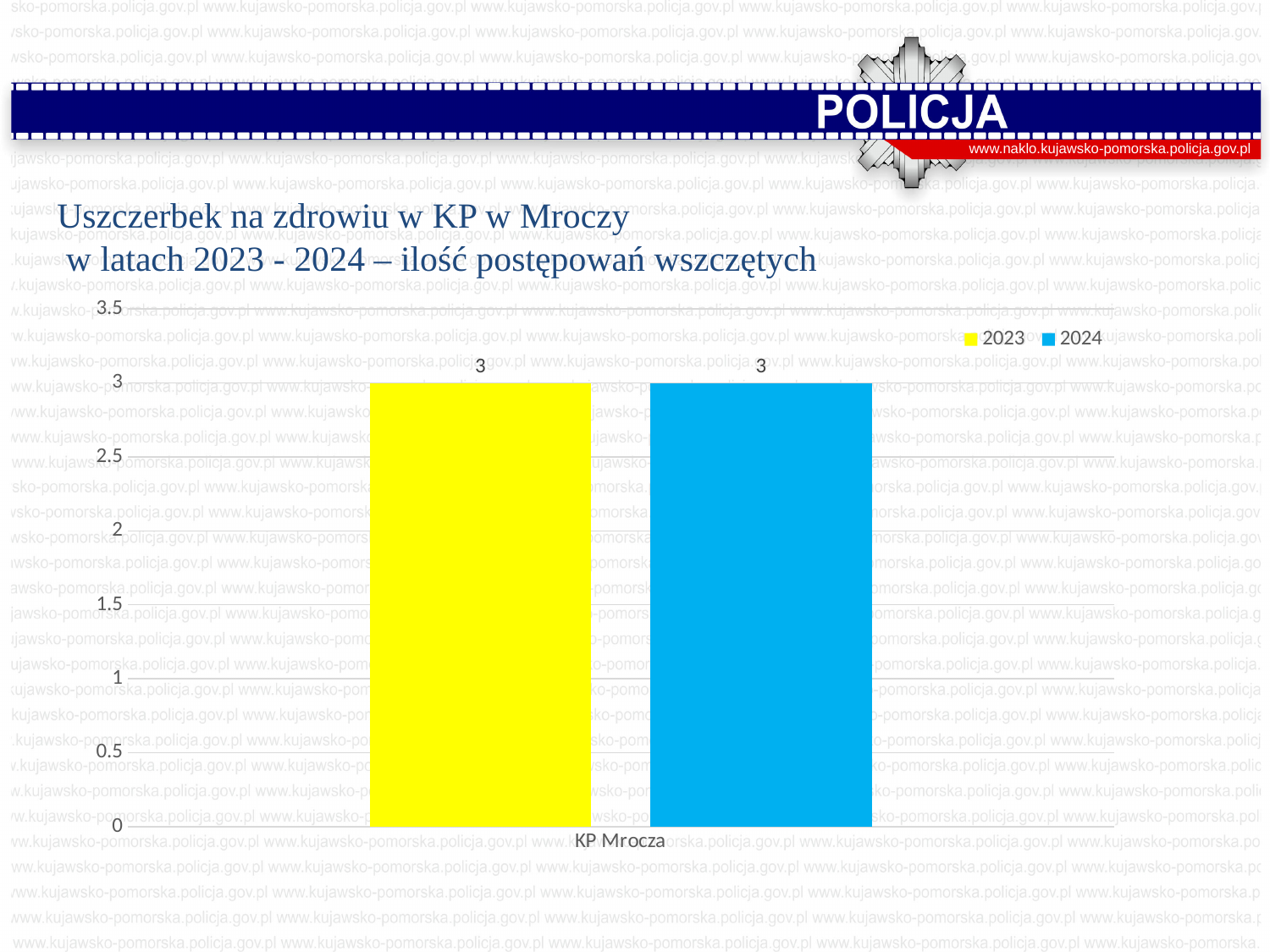
What is the only category label on the x axis? KP Mrocza Is the value for 2023 for KP Mrocza greater or less than 3.5? less Is the value for 2024 for KP Mrocza greater or less than 2.5? greater What is the value for 2024 for KP Mrocza? 3 What kind of chart is shown on the slide? bar chart How many series does the legend list? 2 What is the difference between the 2023 and 2024 values for KP Mrocza? 0 Which colour represents the 2023 series in the legend? yellow What is the value for 2023 for KP Mrocza? 3 What is the total of the 2023 and 2024 values for KP Mrocza? 6 How many categories are shown on the x axis of the chart? 1